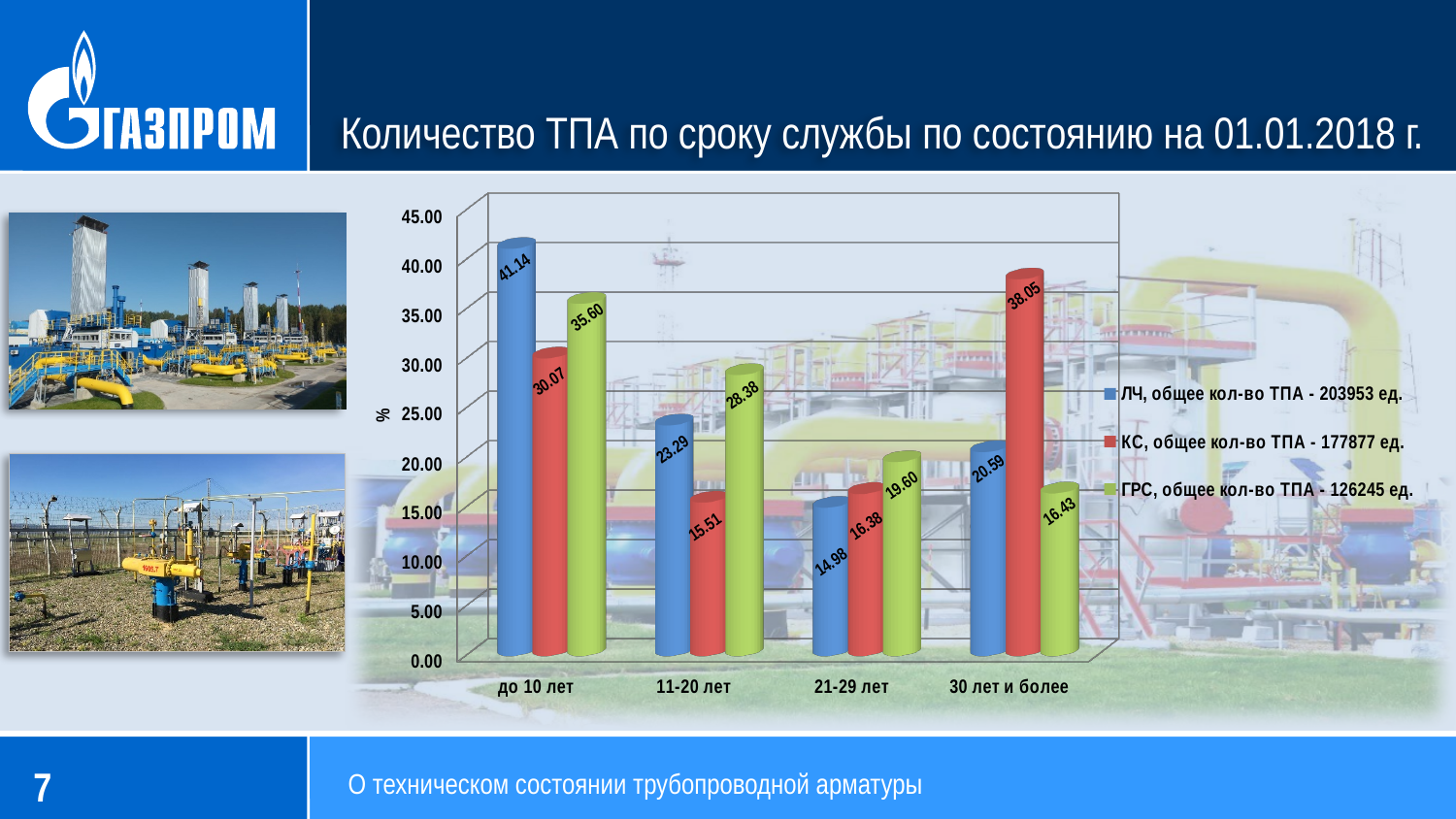
What is the value for ГРС in the '11-20 лет' category? 28.38 Is the value for КС in the '30 лет и более' category greater or less than 35.00? greater What is the value for ЛЧ in the 'до 10 лет' category? 41.14 Which category has the lowest value for the КС series? 11-20 лет Which category has the highest value for the ЛЧ series? до 10 лет How many series does the legend list? 3 In the '21-29 лет' category, which series has the larger value: ЛЧ or ГРС? ГРС How many age categories are shown on the x axis? 4 What kind of chart is shown on the slide? bar chart What is the value for КС in the '30 лет и более' category? 38.05 What is the difference between the ЛЧ and КС values in the 'до 10 лет' category? 11.07 According to the legend, what is the total number of ТПА for ГРС? 126245 ед.